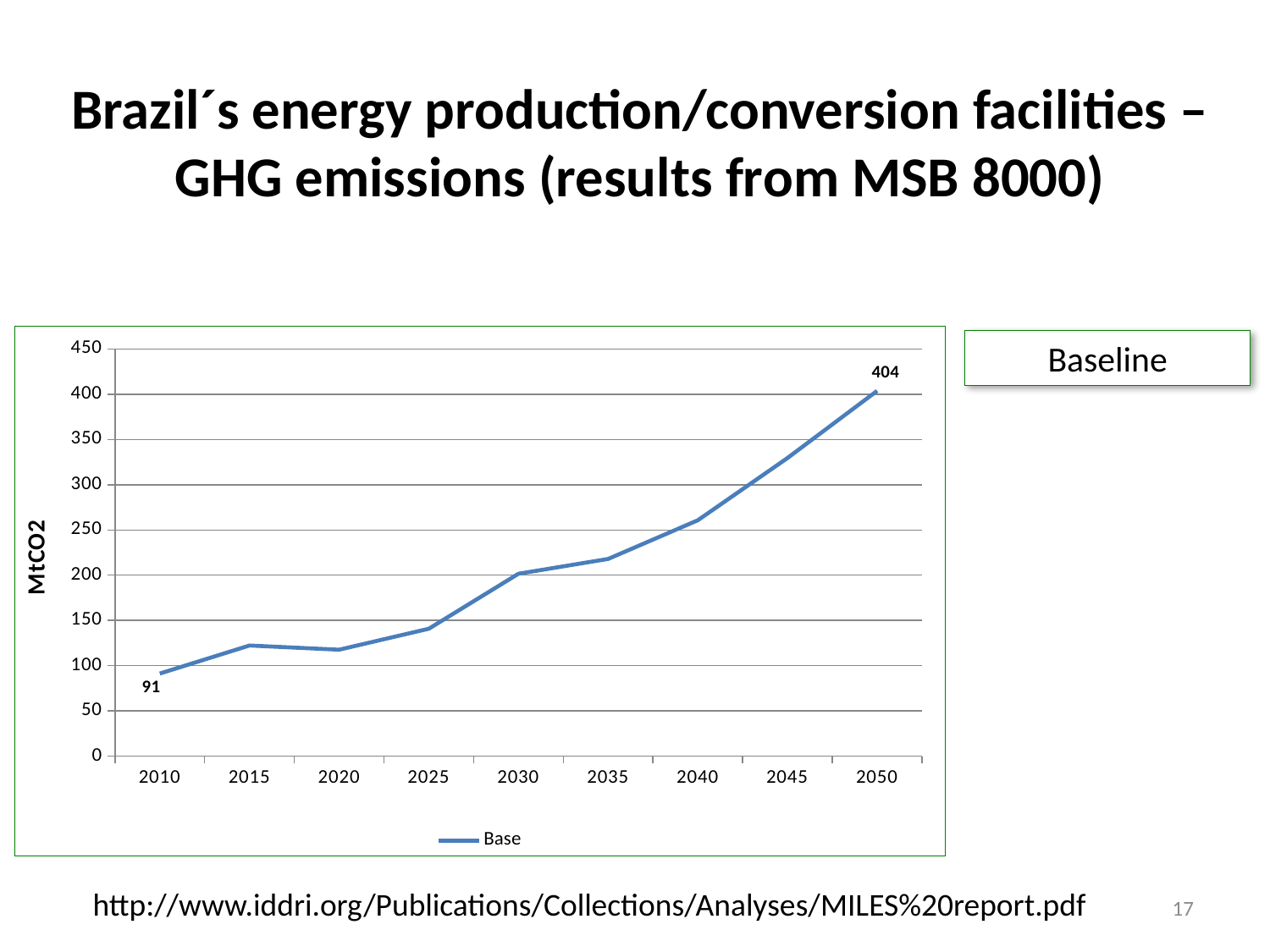
Which is larger, the value for 2040 or the value for 2020? 2040 How many series does the legend list? 1 What is the label on the y axis of the chart? MtCO2 What kind of chart is shown on the slide? line chart How many years are plotted on the x axis? 9 Which year has the highest value on the chart? 2050 What is the value for 2010 on the chart? 91 What is the value for 2050 on the chart? 404 Which year has the lowest value on the chart? 2010 Is the value for 2025 greater or less than 150? less What is the difference between the values for 2050 and 2010? 313 Is the value for 2045 greater or less than 300? greater